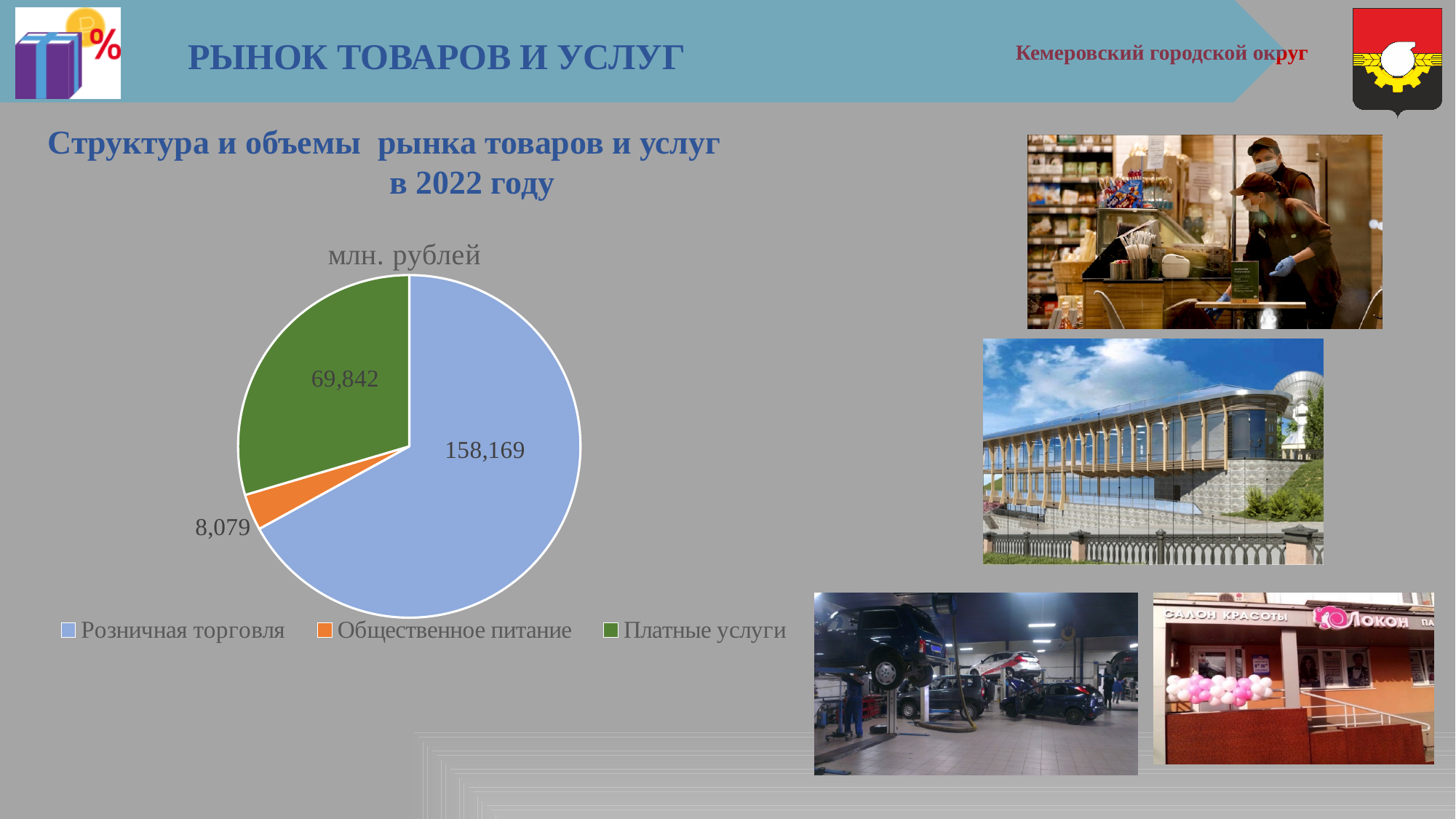
What is the difference between the values for Розничная торговля and Платные услуги? 88,327 Which category has the smallest slice in the pie chart? Общественное питание How many categories does the pie chart show? 3 What is the value for Розничная торговля in the pie chart? 158,169 What is the difference between the values for Платные услуги and Общественное питание? 61,763 What is the value for Платные услуги in the pie chart? 69,842 Which is larger: Платные услуги or Общественное питание? Платные услуги What is the total of all slices in the pie chart? 236,090 What type of chart is shown on the slide? pie chart What unit label is shown above the pie chart? млн. рублей Which category has the largest slice in the pie chart? Розничная торговля What is the value for Общественное питание in the pie chart? 8,079